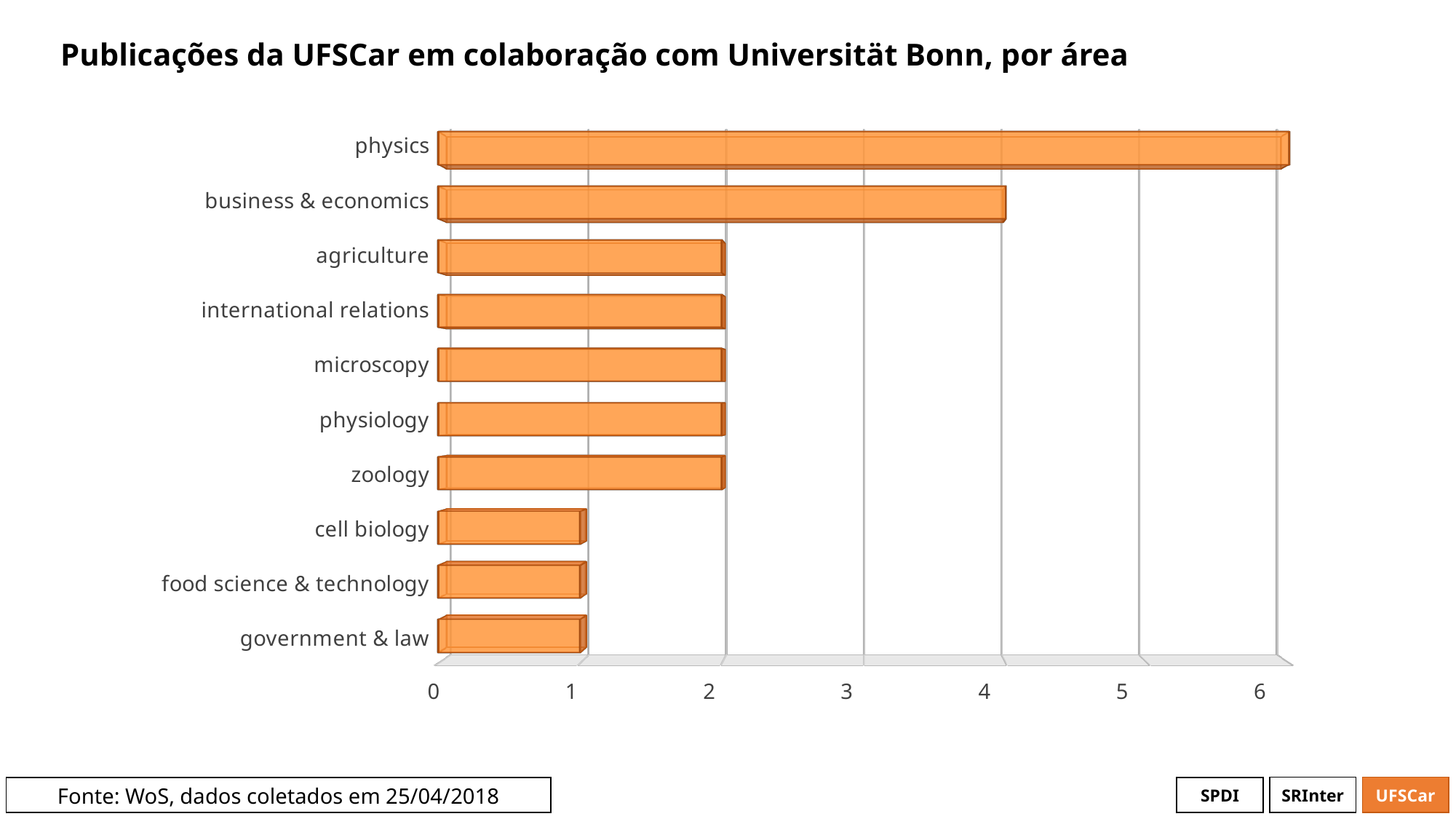
How many publications are shown for agriculture? 2 Is the value for cell biology greater or less than 2? less Which has more publications, business & economics or zoology? business & economics Is the value for physics greater or less than 5? greater How many publications are shown for government & law? 1 How many publications are shown for business & economics? 4 What is the title of the chart? Publicações da UFSCar em colaboração com Universität Bonn, por área How many areas (categories) are shown in the chart? 10 Which area has the highest number of publications? physics What is the difference between the number of publications for physics and for business & economics? 2 What kind of chart is shown on the slide? bar chart How many publications are shown for physics? 6